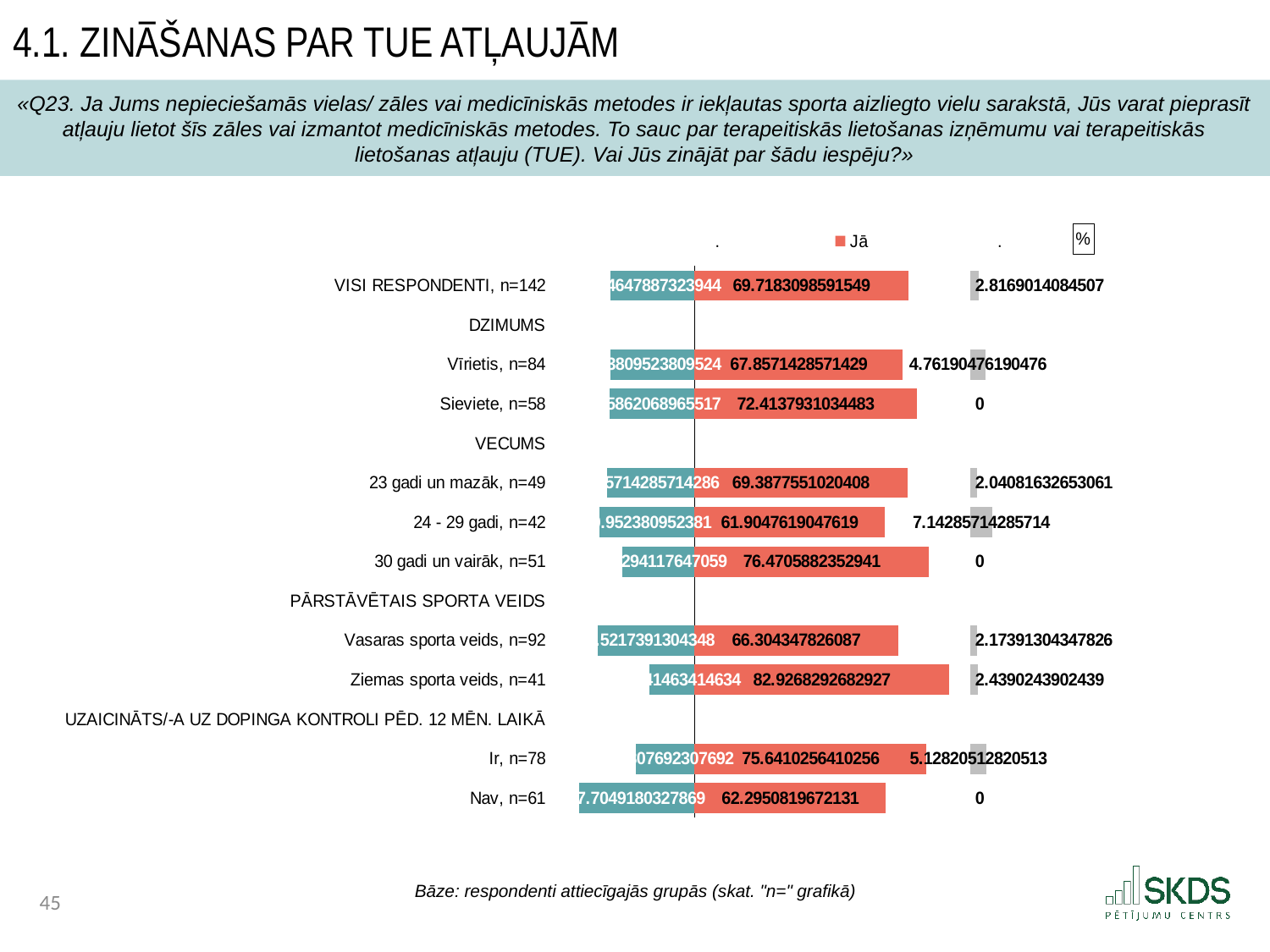
Which has the larger "Jā" value, Vīrietis, n=84 or Sieviete, n=58? Sieviete, n=58 Which group has the highest "Jā" value? Ziemas sporta veids, n=41 Which group has the highest value in the grey (rightmost) segment? 24 - 29 gadi, n=42 What type of chart is shown on the slide? Bar chart Which group has the lowest "Jā" value? 24 - 29 gadi, n=42 What is the value of the grey (rightmost) segment for 24 - 29 gadi, n=42? 7.14285714285714 What is the value of the grey (rightmost) segment for Sieviete, n=58? 0 What is the "Jā" value for Nav, n=61? 62.2950819672131 How many respondent groups have bars plotted in the chart? 10 What is the "Jā" value for VISI RESPONDENTI, n=142? 69.7183098591549 What is the "Jā" value for Ziemas sporta veids, n=41? 82.9268292682927 What is the difference between the grey segment values for 24 - 29 gadi, n=42 and 23 gadi un mazāk, n=49? 5.10204081632653